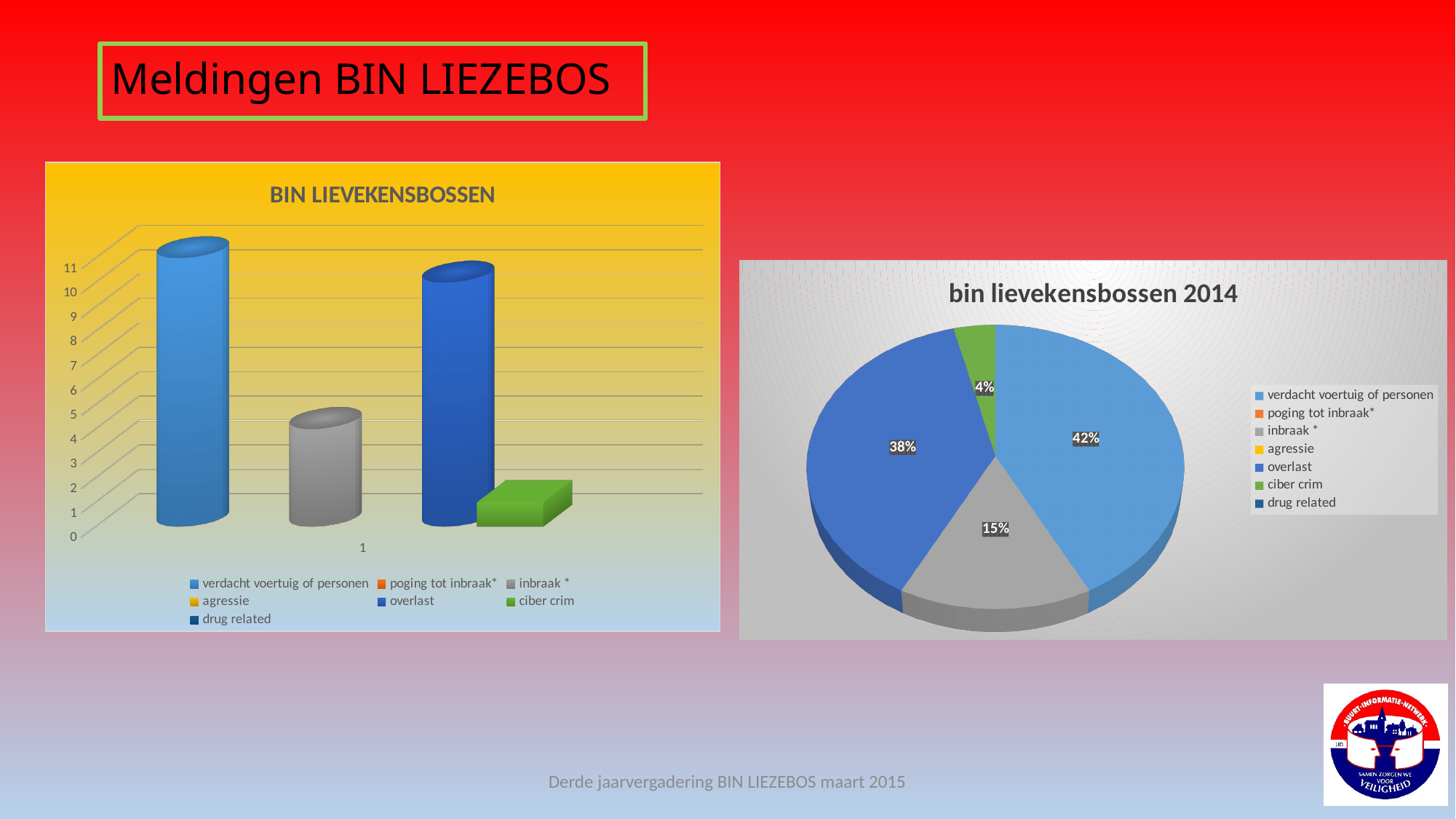
In the pie chart 'bin lievekensbossen 2014', which is larger: 'inbraak *' or 'ciber crim'? inbraak * In the bar chart 'BIN LIEVEKENSBOSSEN', which is larger: 'overlast' or 'ciber crim'? overlast In the pie chart 'bin lievekensbossen 2014', which category has the largest slice? verdacht voertuig of personen In the pie chart 'bin lievekensbossen 2014', what share does 'ciber crim' have? 4% In the pie chart 'bin lievekensbossen 2014', what share does 'inbraak *' have? 15% How many entries does the legend of the pie chart 'bin lievekensbossen 2014' list? 7 In the bar chart 'BIN LIEVEKENSBOSSEN', is the value for 'inbraak *' greater or less than 6? less In the pie chart 'bin lievekensbossen 2014', what share does 'overlast' have? 38% What kind of chart is 'BIN LIEVEKENSBOSSEN' on the left of the slide? bar chart In the pie chart 'bin lievekensbossen 2014', what share does 'verdacht voertuig of personen' have? 42% In the bar chart 'BIN LIEVEKENSBOSSEN', is the value for 'verdacht voertuig of personen' greater or less than 8? greater In the pie chart 'bin lievekensbossen 2014', what is the difference in percentage points between 'verdacht voertuig of personen' and 'overlast'? 4